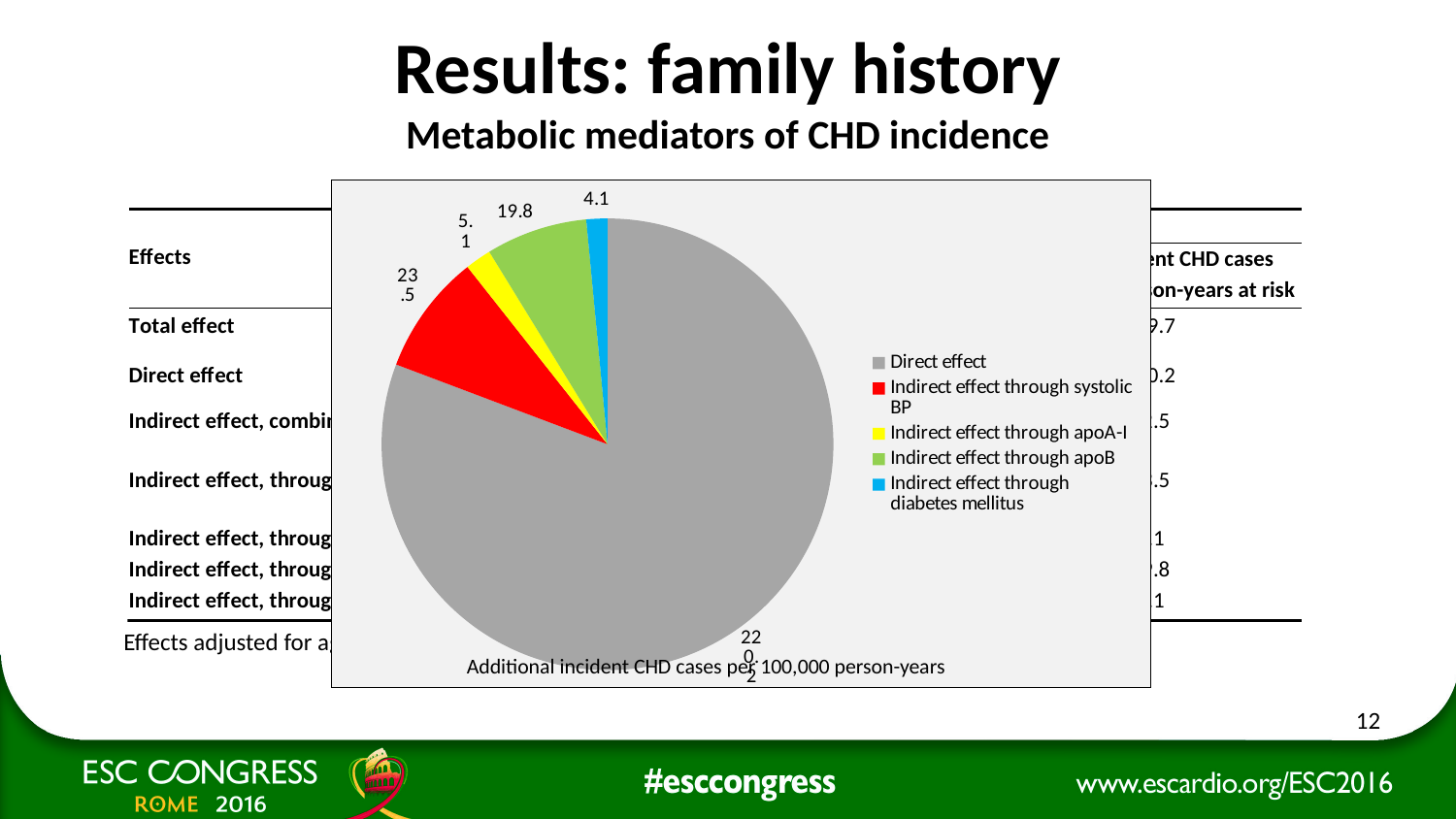
Which slice of the pie chart is the smallest? Indirect effect through diabetes mellitus What colour is the slice for the indirect effect through apoA-I? yellow How many entries does the legend of the pie chart list? 5 What is the value shown for the indirect effect through apoA-I? 5.1 Which is larger: the indirect effect through systolic BP or the indirect effect through apoB? Indirect effect through systolic BP What is the value shown for the indirect effect through systolic BP? 23.5 What is the difference between the indirect effect through systolic BP and the indirect effect through apoB? 3.7 What kind of chart is shown on the slide? pie chart Which slice of the pie chart is the largest? Direct effect How many slices does the pie chart have? 5 What is the value shown for the indirect effect through apoB? 19.8 What is the value shown for the indirect effect through diabetes mellitus? 4.1